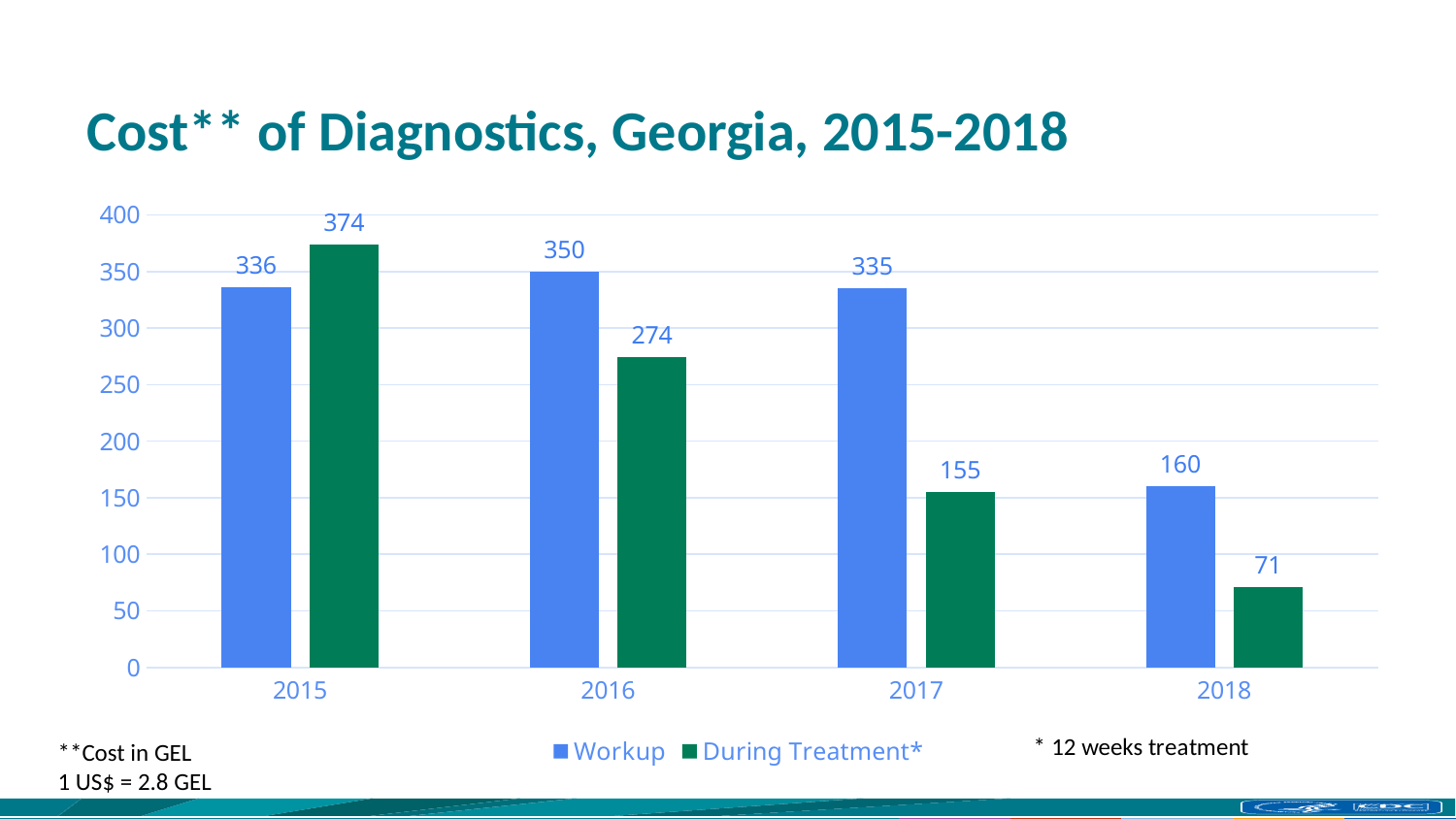
Which year has the highest Workup cost? 2016 What is the difference between the Workup and During Treatment costs in 2017? 180 How many series does the legend list? 2 What is the During Treatment cost in 2015? 374 What kind of chart is shown on the slide? bar chart How many years are shown on the x axis? 4 What is the Workup cost in 2016? 350 Does the During Treatment cost rise or fall from 2015 to 2018? fall What is the During Treatment cost in 2018? 71 In 2015, which is larger: the Workup cost or the During Treatment cost? During Treatment Is the Workup cost in 2018 greater or less than 200? less Which year has the lowest During Treatment cost? 2018